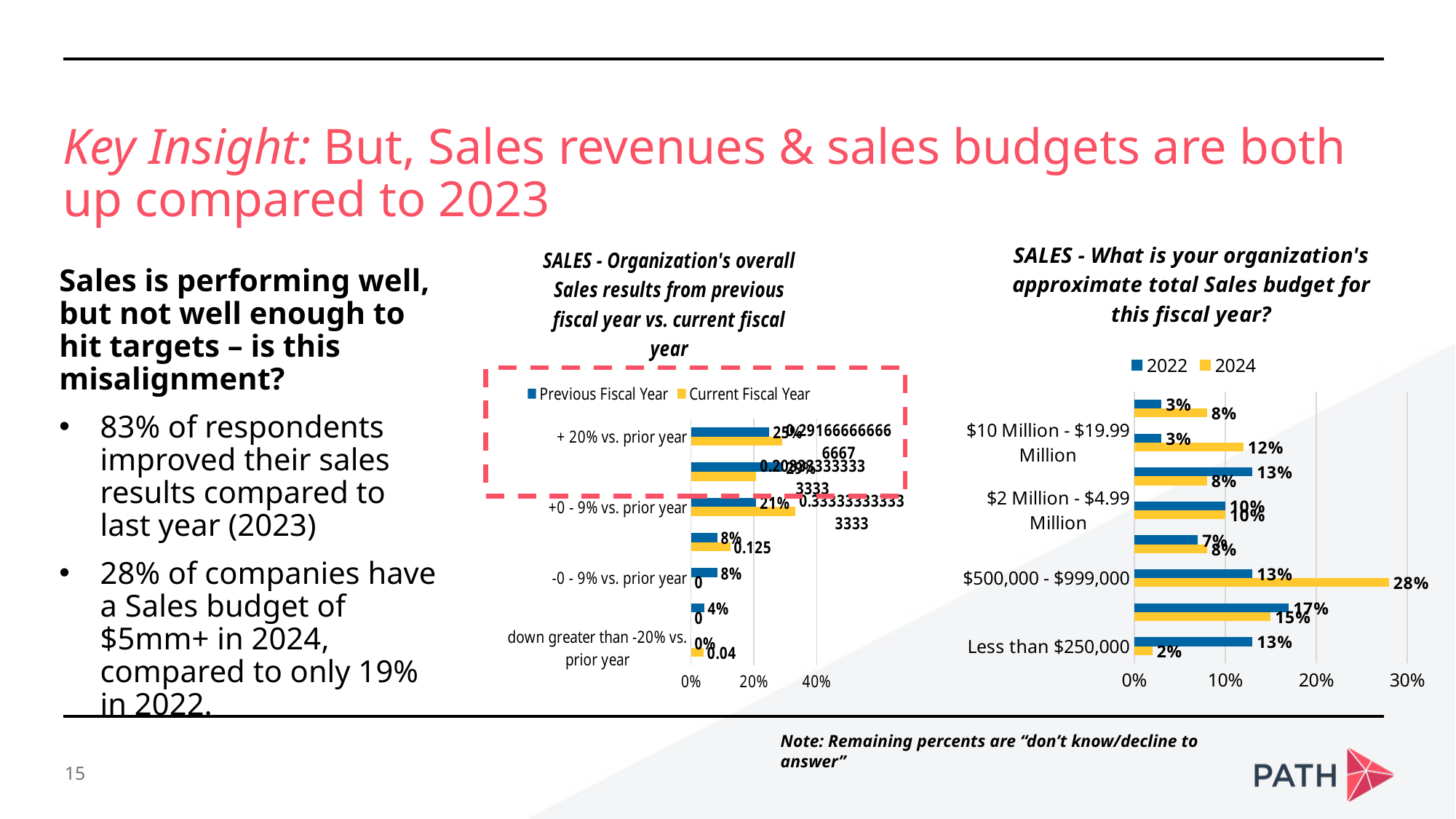
In the chart titled 'SALES - What is your organization's approximate total Sales budget for this fiscal year?', what is the 2022 value for 'Less than $250,000'? 13% How many series does the legend of the chart titled 'SALES - What is your organization's approximate total Sales budget for this fiscal year?' list? 2 In the chart titled 'SALES - What is your organization's approximate total Sales budget for this fiscal year?', what is the 2024 value for '$10 Million - $19.99 Million'? 12% In the chart titled 'SALES - Organization's overall Sales results from previous fiscal year vs. current fiscal year', what is the Previous Fiscal Year value for 'down greater than -20% vs. prior year'? 0% In the chart titled 'SALES - What is your organization's approximate total Sales budget for this fiscal year?', what is the 2024 value for 'Less than $250,000'? 2% In the chart titled 'SALES - Organization's overall Sales results from previous fiscal year vs. current fiscal year', what is the Previous Fiscal Year value for '-0 - 9% vs. prior year'? 8% What are the two legend entries in the chart titled 'SALES - Organization's overall Sales results from previous fiscal year vs. current fiscal year'? Previous Fiscal Year and Current Fiscal Year What kind of chart is the chart titled 'SALES - What is your organization's approximate total Sales budget for this fiscal year?'? Bar chart In the chart titled 'SALES - What is your organization's approximate total Sales budget for this fiscal year?', what is the 2024 value for '$500,000 - $999,000'? 28% In the chart titled 'SALES - What is your organization's approximate total Sales budget for this fiscal year?', which category has the highest 2024 value? $500,000 - $999,000 In the chart titled 'SALES - What is your organization's approximate total Sales budget for this fiscal year?', what is the difference between the 2024 and 2022 values for '$500,000 - $999,000'? 15% In the chart titled 'SALES - What is your organization's approximate total Sales budget for this fiscal year?', which is larger for '$10 Million - $19.99 Million': the 2022 value or the 2024 value? 2024